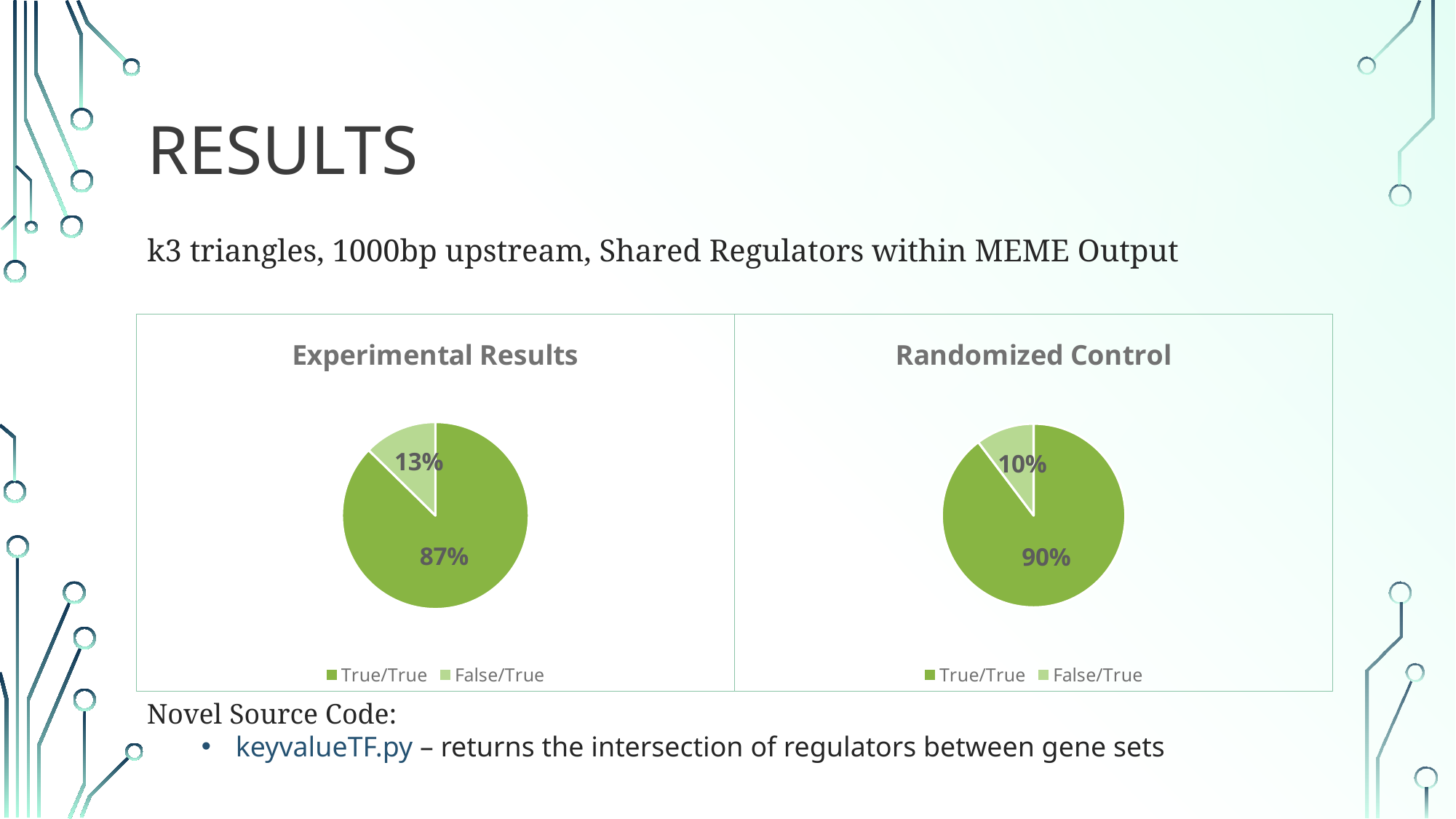
In the Experimental Results chart, which slice is the largest? True/True Which chart has the larger False/True share, Experimental Results or Randomized Control? Experimental Results In the Randomized Control chart, what share of the pie is False/True? 10% How many slices does the Experimental Results pie chart have? 2 In the Experimental Results chart, what share of the pie is True/True? 87% In the Randomized Control chart, what share of the pie is True/True? 90% What kind of chart is the Randomized Control chart? Pie chart In the Experimental Results chart, what is the difference between the True/True and False/True shares? 74% What is the title of the chart on the left side of the slide? Experimental Results In the Randomized Control chart, which slice is the smallest? False/True How many entries does the legend of the Randomized Control chart list? 2